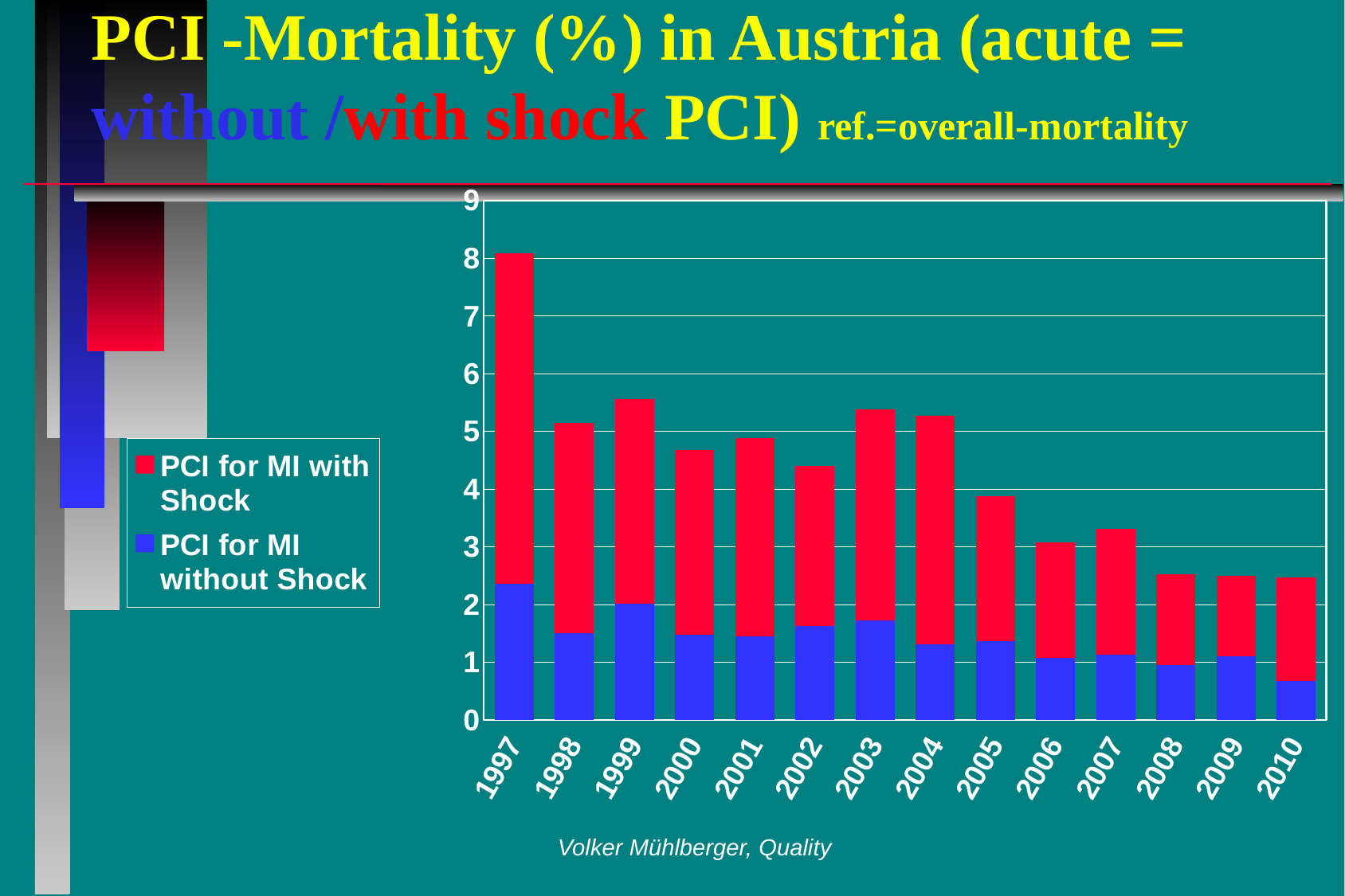
Which year has the larger total bar, 1998 or 1999? 1999 Which year has the highest total PCI mortality bar? 1997 Which colour represents PCI for MI with Shock in the legend? Red How many years are shown on the x axis of the chart? 14 Is the total bar for 2002 greater or less than 5? less Which year has the highest value for PCI for MI without Shock? 1997 Is the total bar for 1997 greater or less than 7? greater Do the total bars generally rise or fall from 1997 to 2010? Fall What kind of chart is shown on the slide? Stacked bar chart How many series does the legend list? 2 Which year has the lowest value for PCI for MI without Shock? 2010 Is the total bar for 2010 greater or less than 3? less